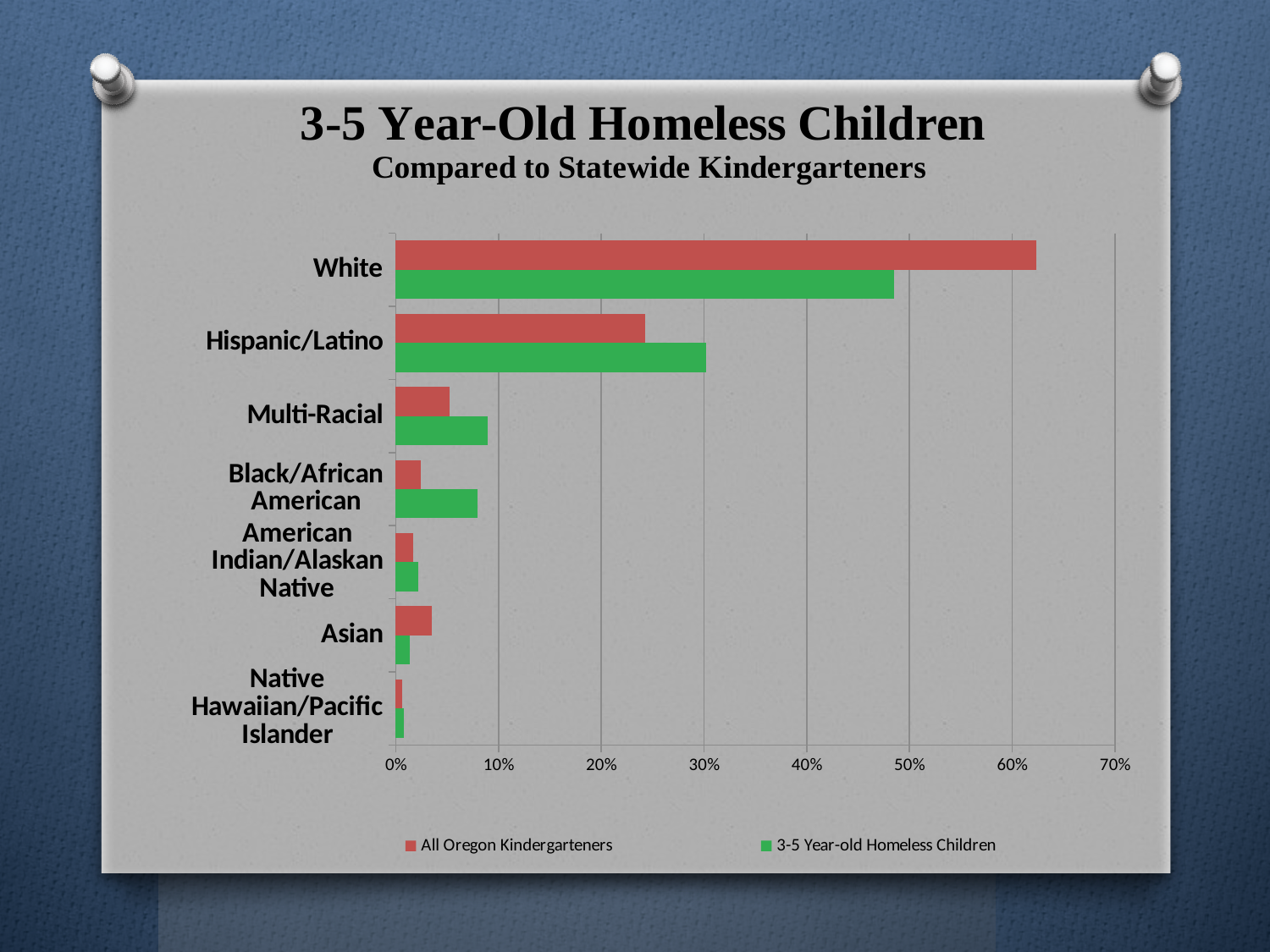
For the Hispanic/Latino category, which series has the larger value: All Oregon Kindergarteners or 3-5 Year-old Homeless Children? 3-5 Year-old Homeless Children How many series does the legend list? 2 Is the value for White among All Oregon Kindergarteners greater or less than 60%? greater Is the value for Hispanic/Latino among All Oregon Kindergarteners greater or less than 30%? less What kind of chart is shown on the slide? Bar chart Is the value for White among 3-5 Year-old Homeless Children greater or less than 50%? less What is the main title of the chart on the slide? 3-5 Year-Old Homeless Children For the White category, which series has the larger value: All Oregon Kindergarteners or 3-5 Year-old Homeless Children? All Oregon Kindergarteners For the Asian category, which series has the larger value: All Oregon Kindergarteners or 3-5 Year-old Homeless Children? All Oregon Kindergarteners How many racial/ethnic categories are plotted on the chart? 7 Which category has the highest value for All Oregon Kindergarteners? White Which category has the lowest value for 3-5 Year-old Homeless Children? Native Hawaiian/Pacific Islander